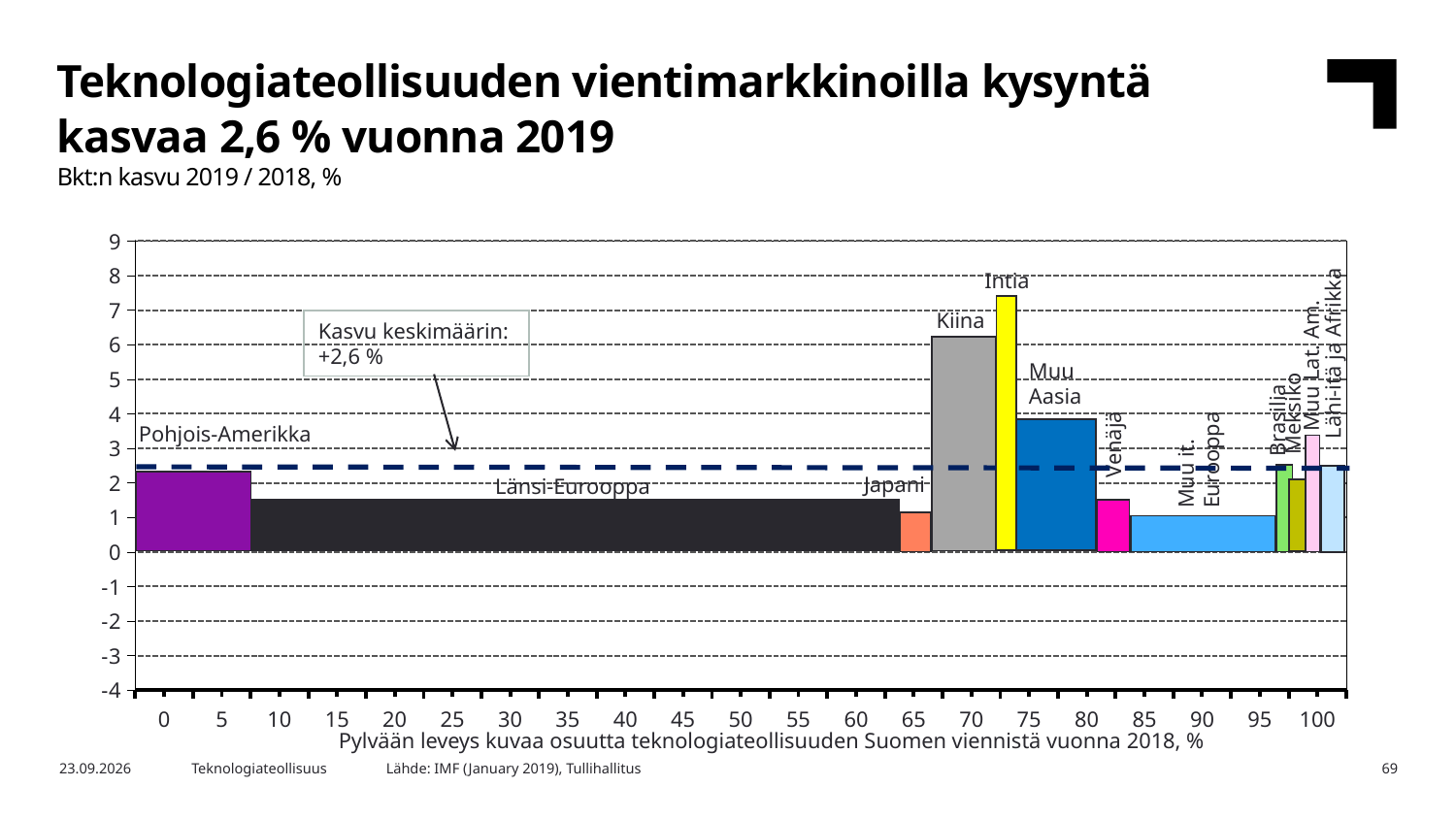
Which region has the highest GDP growth in the chart? Intia Which has the larger value, Kiina or Intia? Intia Is the value for Japani greater or less than 2? less How many regions are labelled in the chart? 12 Is the value for Kiina greater or less than 5? greater Which has the larger value, Pohjois-Amerikka or Länsi-Eurooppa? Pohjois-Amerikka What average growth does the dashed line in the chart represent? +2,6 % According to the note under the x axis, what does the width of each bar represent? Share of Finland's technology industry exports in 2018, % Is the value for Länsi-Eurooppa greater or less than 2? less What kind of chart is shown on the slide? bar chart